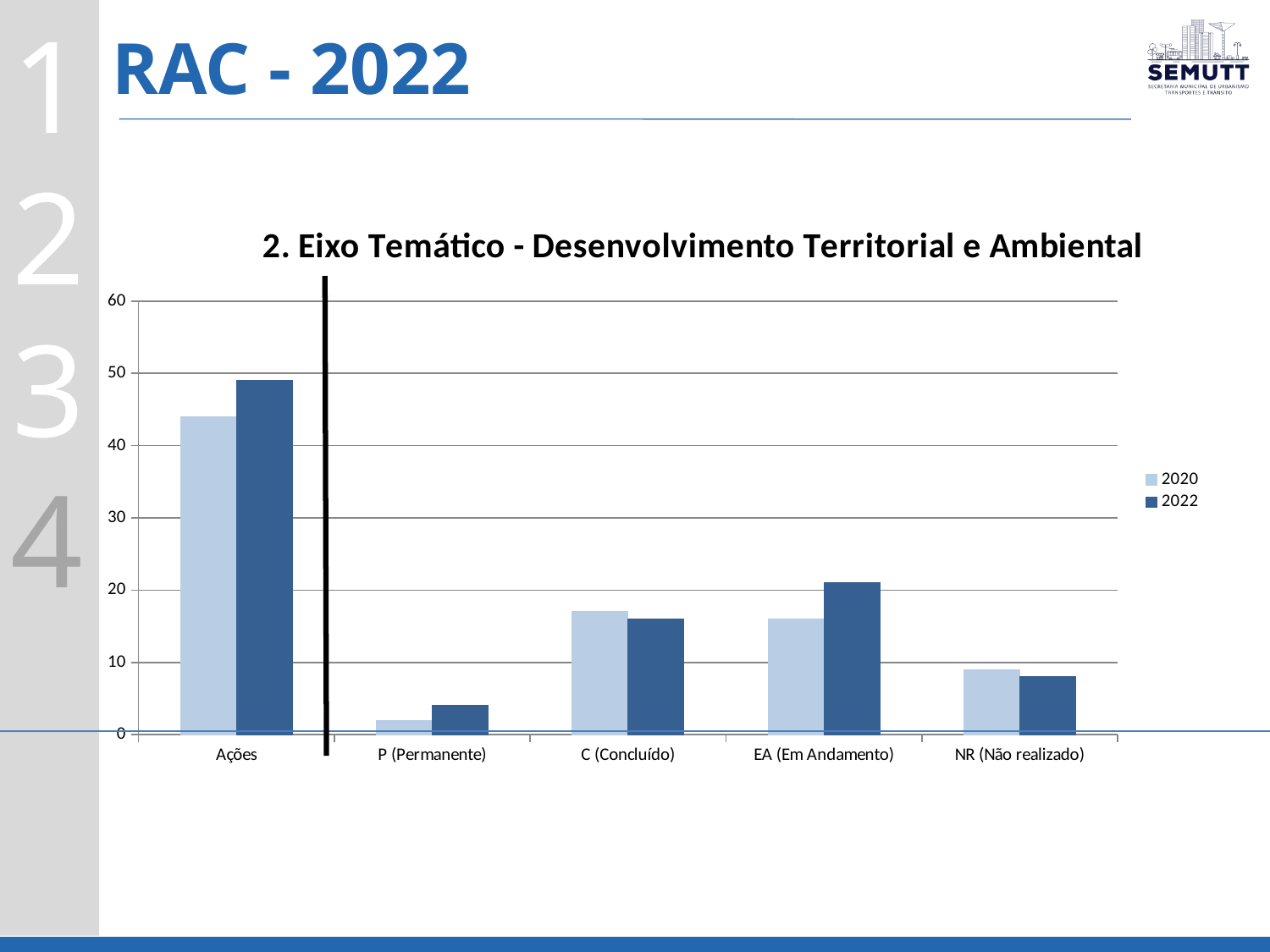
Is the 2020 value for Ações greater or less than 40? greater Which category has the highest value for the 2022 series? Ações Is the 2020 value for C (Concluído) greater or less than 20? less Which category has the lowest value for the 2022 series? P (Permanente) How many categories are shown on the x axis? 5 For EA (Em Andamento), which series has the larger value, 2020 or 2022? 2022 For Ações, which series has the larger value, 2020 or 2022? 2022 How many series does the legend list? 2 What type of chart is shown on the slide? bar chart What is the title of the chart? 2. Eixo Temático - Desenvolvimento Territorial e Ambiental Which category has the lowest value for the 2020 series? P (Permanente)